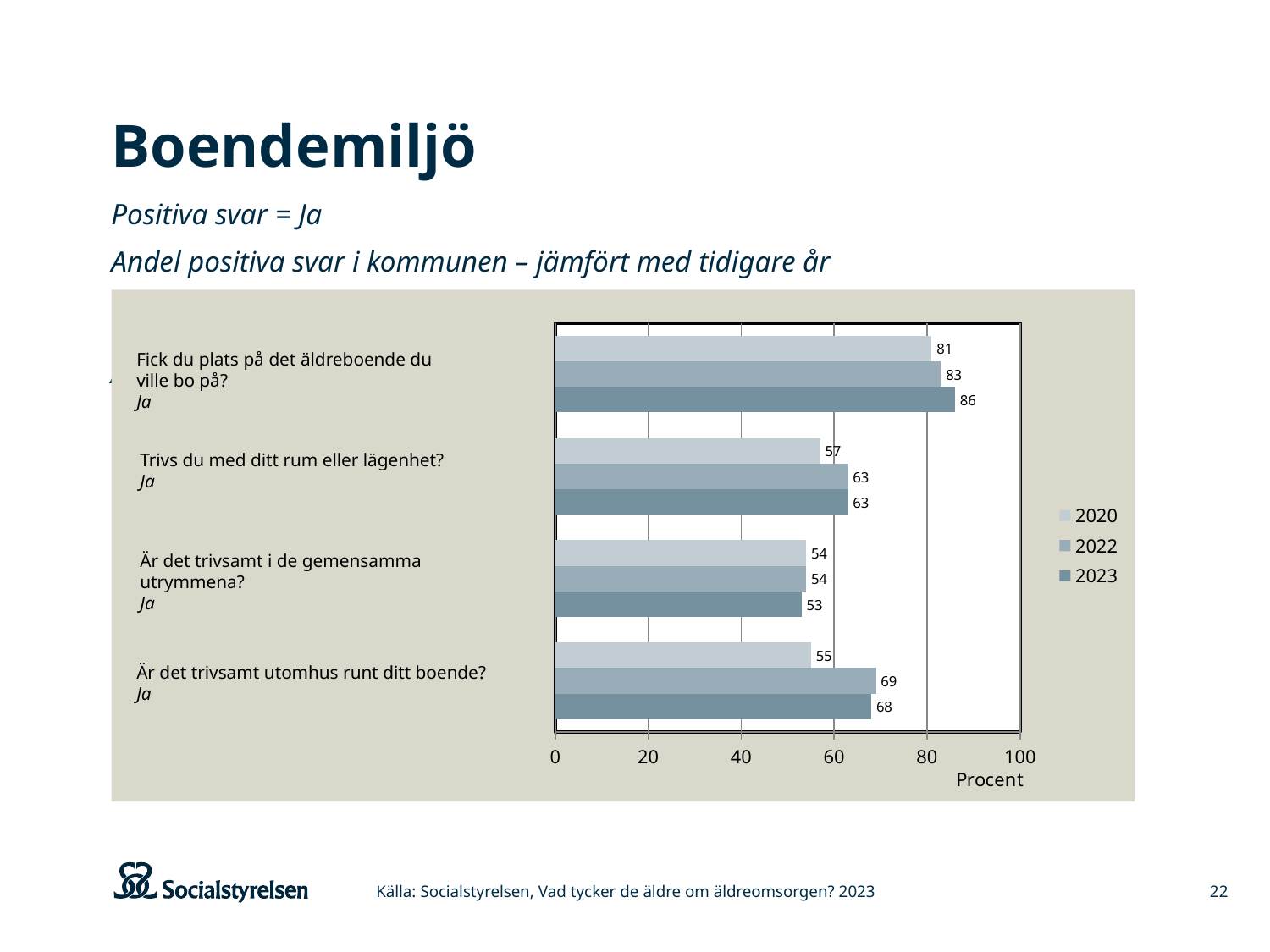
How many questions (categories) are shown in the chart? 4 What kind of chart is shown on the slide? Bar chart What is the 2022 value for "Är det trivsamt utomhus runt ditt boende?"? 69 What is the 2023 value for "Är det trivsamt i de gemensamma utrymmena?"? 53 What is the difference between the 2022 and 2020 values for "Är det trivsamt utomhus runt ditt boende?"? 14 What is the 2023 value for "Fick du plats på det äldreboende du ville bo på?"? 86 Which question has the lowest 2020 value? Är det trivsamt i de gemensamma utrymmena? What is the label of the horizontal axis? Procent What is the 2020 value for "Trivs du med ditt rum eller lägenhet?"? 57 How many series does the legend list? 3 For "Fick du plats på det äldreboende du ville bo på?", which year has the larger value, 2020 or 2023? 2023 Which question has the highest 2023 value? Fick du plats på det äldreboende du ville bo på?